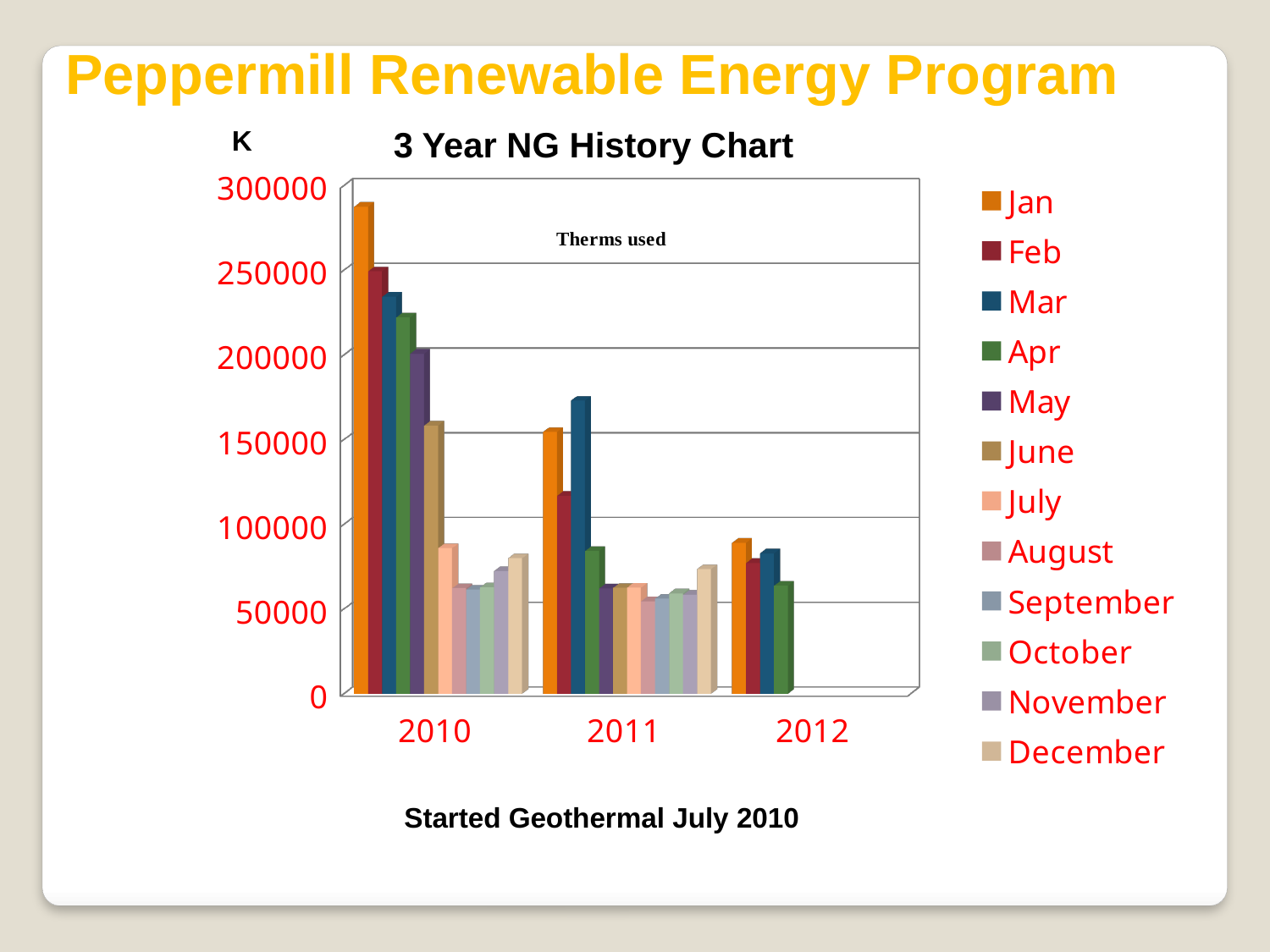
What does the text below the chart say? Started Geothermal July 2010 Is the value for Jan in 2012 greater or less than 100000? less How many series does the legend of the 3 Year NG History Chart list? 12 Is the value for Mar in 2011 greater or less than 150000? greater What is the title of the chart on the slide? 3 Year NG History Chart Which month has the highest value in 2010? Jan Which is larger, the Jan value for 2010 or the Jan value for 2011? 2010 Is the value for Jan in 2010 greater or less than 250000? greater Which month has the highest value in 2011? Mar What kind of chart is the 3 Year NG History Chart? bar chart How many years (categories) are shown on the x axis of the 3 Year NG History Chart? 3